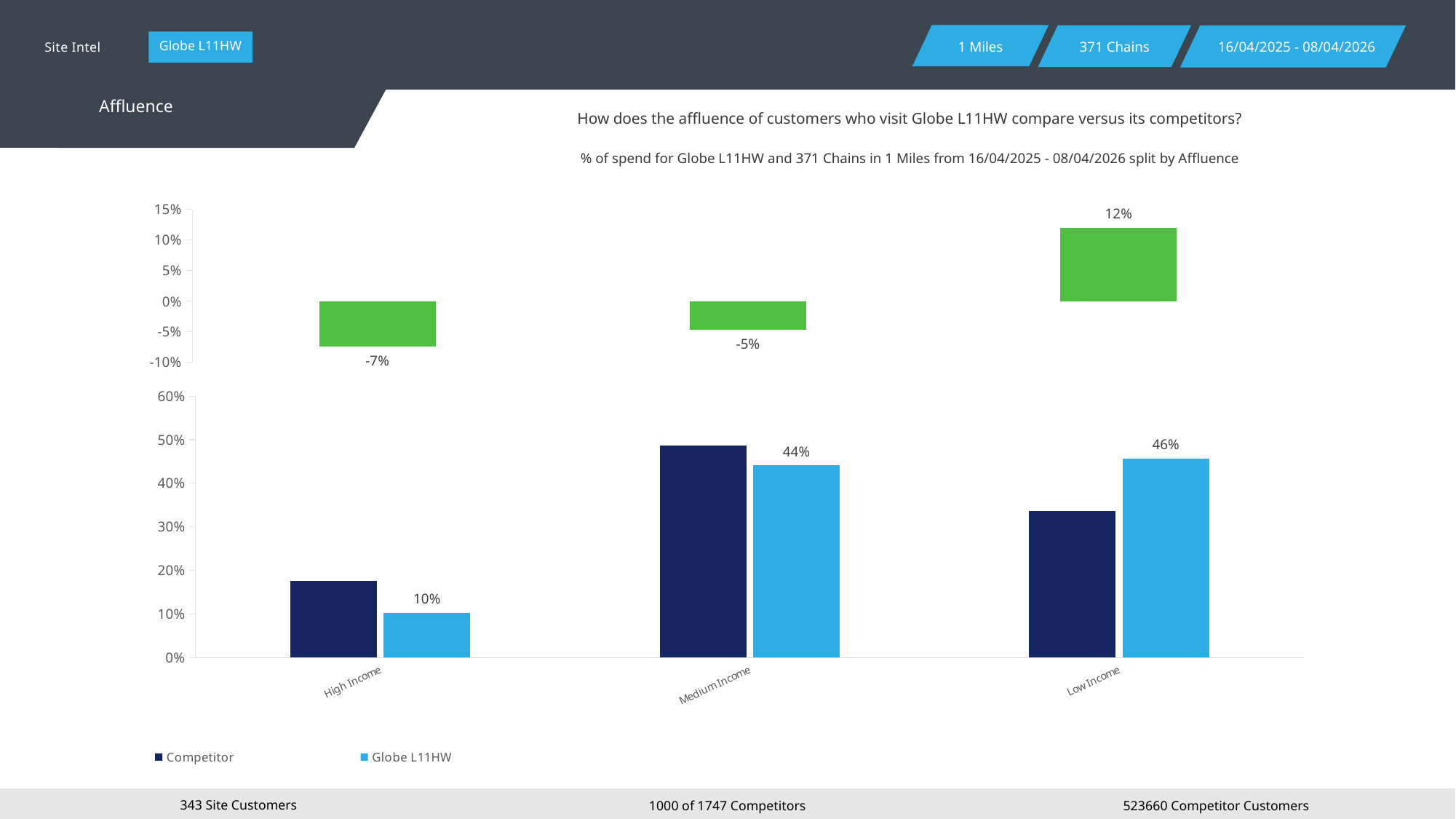
In the bottom chart, what is the value for Globe L11HW in the High Income category? 10% In the bottom chart, which is larger for Low Income: the Competitor value or the Globe L11HW value? Globe L11HW What kind of chart is the bottom chart? Bar chart In the bottom chart, is the Competitor value for Medium Income greater or less than 40%? greater In the bottom chart, what is the value for Globe L11HW in the Low Income category? 46% How many series does the legend of the bottom chart list? 2 In the bottom chart, what is the value for Globe L11HW in the Medium Income category? 44% In the top chart, what is the value for the Low Income category? 12% In the bottom chart, which category has the lowest Globe L11HW value? High Income In the top chart, what is the value for the High Income category? -7% In the top chart, which category has the lowest value? High Income In the bottom chart, what is the difference between the Globe L11HW values for Low Income and High Income? 36%